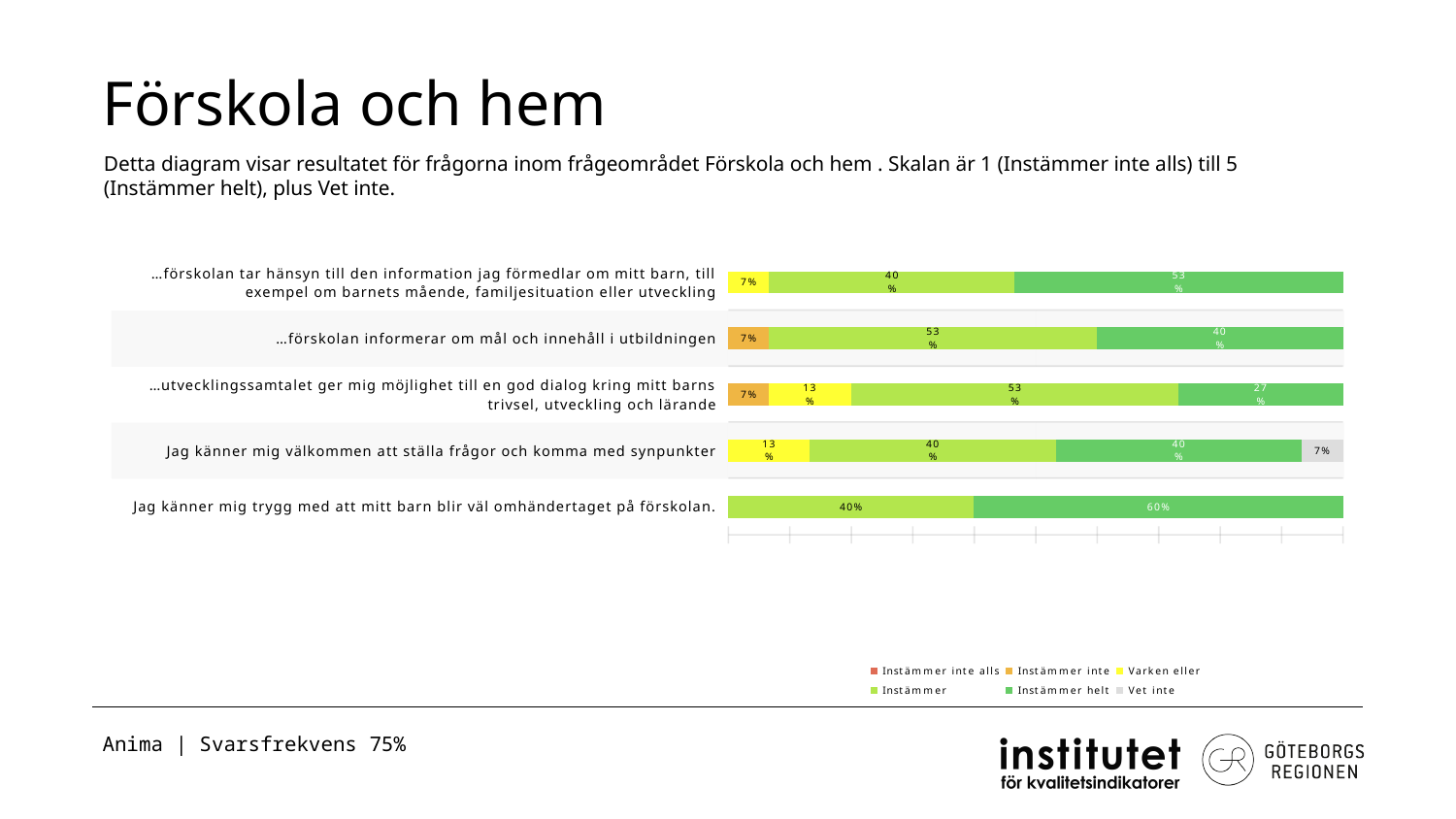
What is the difference between the 'Instämmer helt' values for '…förskolan tar hänsyn till den information jag förmedlar om mitt barn…' and '…förskolan informerar om mål och innehåll i utbildningen'? 13% What is the 'Instämmer' value for '…förskolan informerar om mål och innehåll i utbildningen'? 53% What is the total of the 'Instämmer' and 'Instämmer helt' segments for 'Jag känner mig välkommen att ställa frågor och komma med synpunkter'? 80% Which category has the lowest 'Instämmer helt' value? …utvecklingssamtalet ger mig möjlighet till en god dialog kring mitt barns trivsel, utveckling och lärande Which is larger: the 'Instämmer' value or the 'Instämmer helt' value for '…utvecklingssamtalet ger mig möjlighet till en god dialog kring mitt barns trivsel, utveckling och lärande'? Instämmer What is the 'Instämmer helt' value for 'Jag känner mig trygg med att mitt barn blir väl omhändertaget på förskolan.'? 60% How many series does the legend list? 6 Which category has the highest 'Instämmer helt' value? Jag känner mig trygg med att mitt barn blir väl omhändertaget på förskolan. What is the 'Varken eller' value for '…utvecklingssamtalet ger mig möjlighet till en god dialog kring mitt barns trivsel, utveckling och lärande'? 13% What is the 'Vet inte' value for 'Jag känner mig välkommen att ställa frågor och komma med synpunkter'? 7% What kind of chart is shown on the slide? Stacked bar chart How many question categories are plotted in the chart? 5